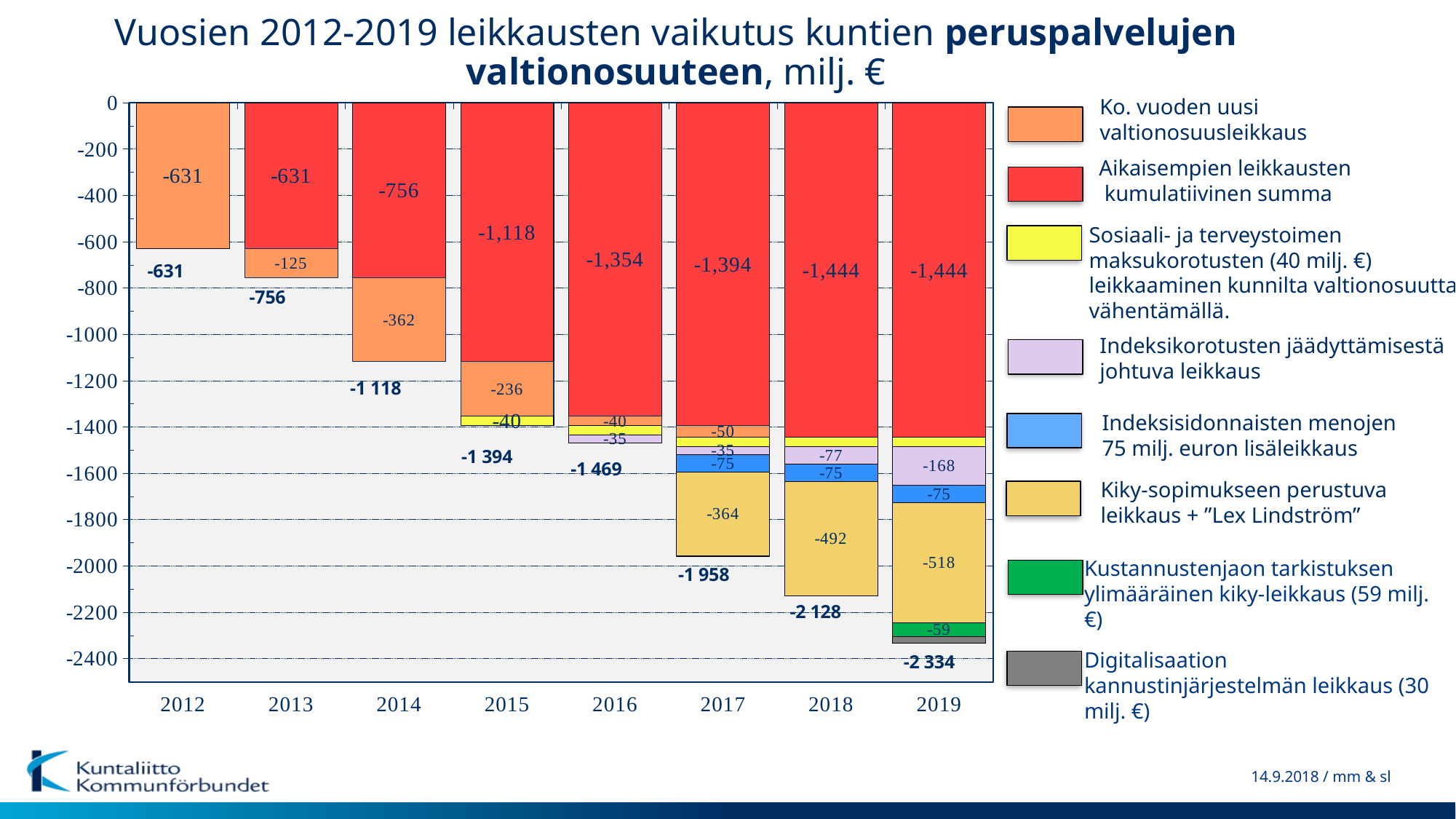
What is the value of the Kustannustenjaon tarkistuksen ylimääräinen kiky-leikkaus segment in 2019? -59 Do the total cuts grow or shrink in magnitude from 2012 to 2019? Grow What is the value of the Aikaisempien leikkausten kumulatiivinen summa segment in 2017? -1,394 What kind of chart is shown on the slide? Stacked bar chart How many series does the legend list? 8 Which year has the largest total cut (the longest bar)? 2019 What is the difference between the total for 2019 (-2 334) and the total for 2018 (-2 128)? 206 What is the total value printed below the bar for 2012? -631 What is the value of the Ko. vuoden uusi valtionosuusleikkaus segment in 2014? -362 What is the total value printed below the bar for 2019? -2 334 What is the value of the Kiky-sopimukseen perustuva leikkaus segment in 2018? -492 How many years are shown on the x axis of the chart? 8